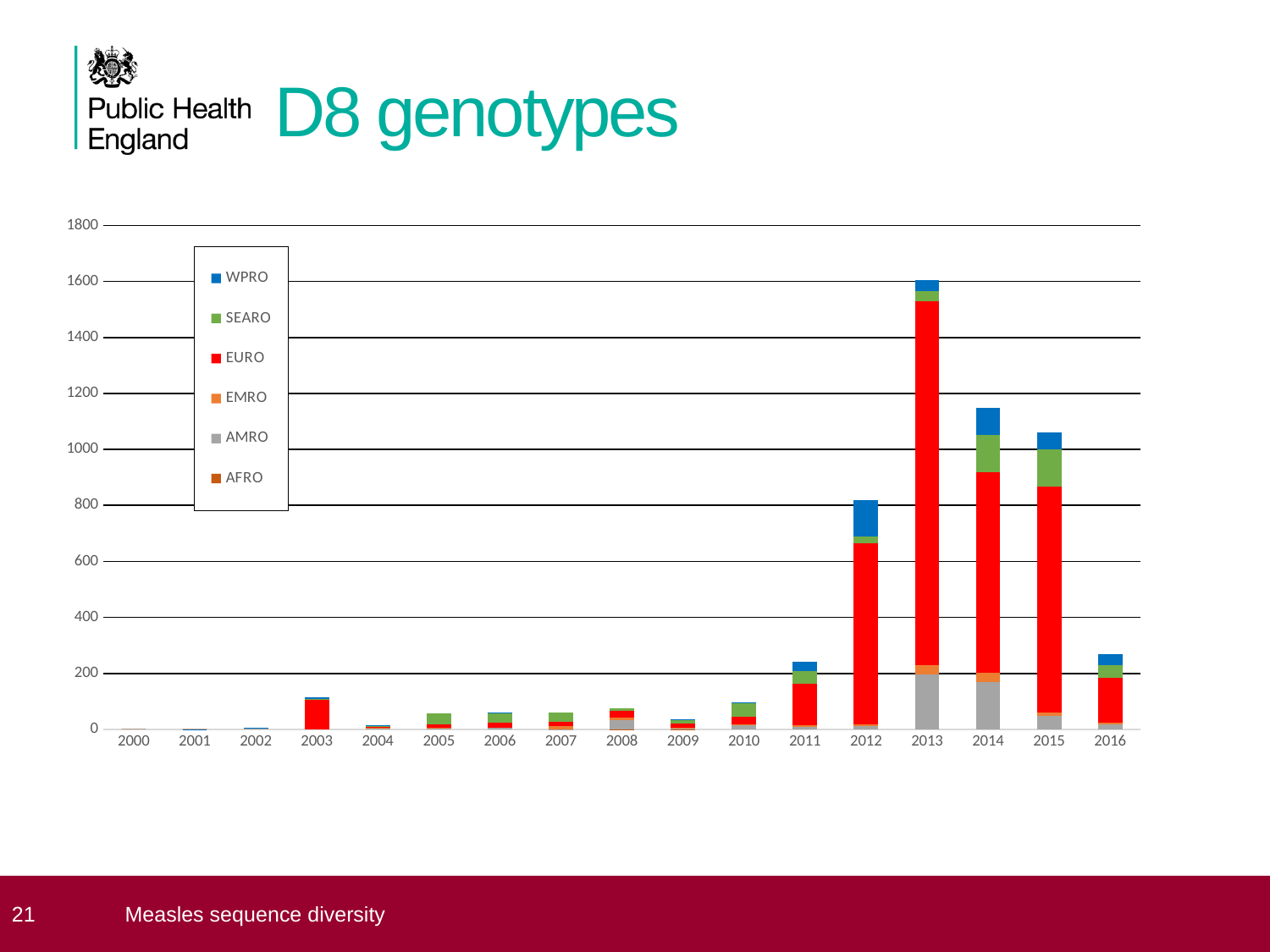
Do the total bar heights rise or fall from 2013 to 2015? fall Which year has the larger total bar, 2012 or 2013? 2013 How many series does the legend list? 6 How many years are shown along the x axis? 17 Is the total for 2014 greater or less than 1000? greater Which colour represents the EURO series in the legend? Red What kind of chart is shown on the slide? Stacked bar chart Which year has the highest total bar? 2013 Is the total for 2013 greater or less than 1400? greater What is the title of the chart? D8 genotypes Is the total for 2003 greater or less than 200? less